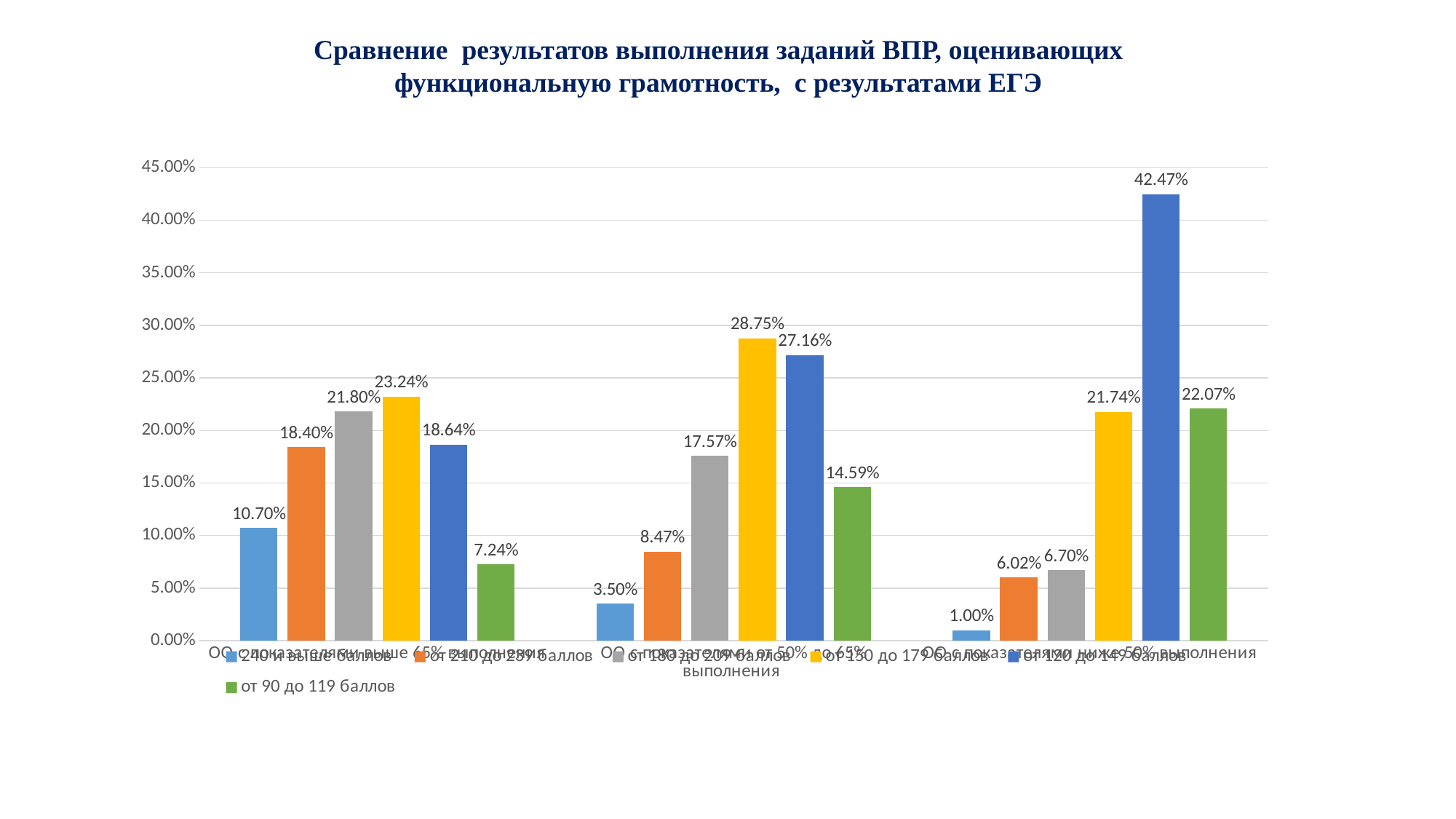
Does the light blue series (240 и выше баллов) rise or fall across the three categories from left to right? fall What is the difference between the yellow bar (28.75%) and the dark blue bar (27.16%) in the category 'ОО с показателями от 50% до 65% выполнения'? 1.59% In the category 'ОО с показателями выше 65% выполнения', which is larger: the value for 'от 150 до 179 баллов' or the value for 'от 180 до 209 баллов'? от 150 до 179 баллов What is the value for the light blue series (240 и выше баллов) in the category 'ОО с показателями от 50% до 65% выполнения'? 3.50% What is the highest value labelled anywhere on the chart? 42.47% Which series has the lowest value in the category 'ОО с показателями выше 65% выполнения'? от 90 до 119 баллов Which series has the highest value in the category 'ОО с показателями ниже 50% выполнения'? от 120 до 149 баллов What kind of chart is shown on the slide? bar chart How many series does the legend list? 6 How many categories are shown along the x axis? 3 Is the value for 'от 120 до 149 баллов' in the category 'ОО с показателями ниже 50% выполнения' greater or less than 40.00%? greater What is the value for the green series (от 90 до 119 баллов) in the category 'ОО с показателями ниже 50% выполнения'? 22.07%